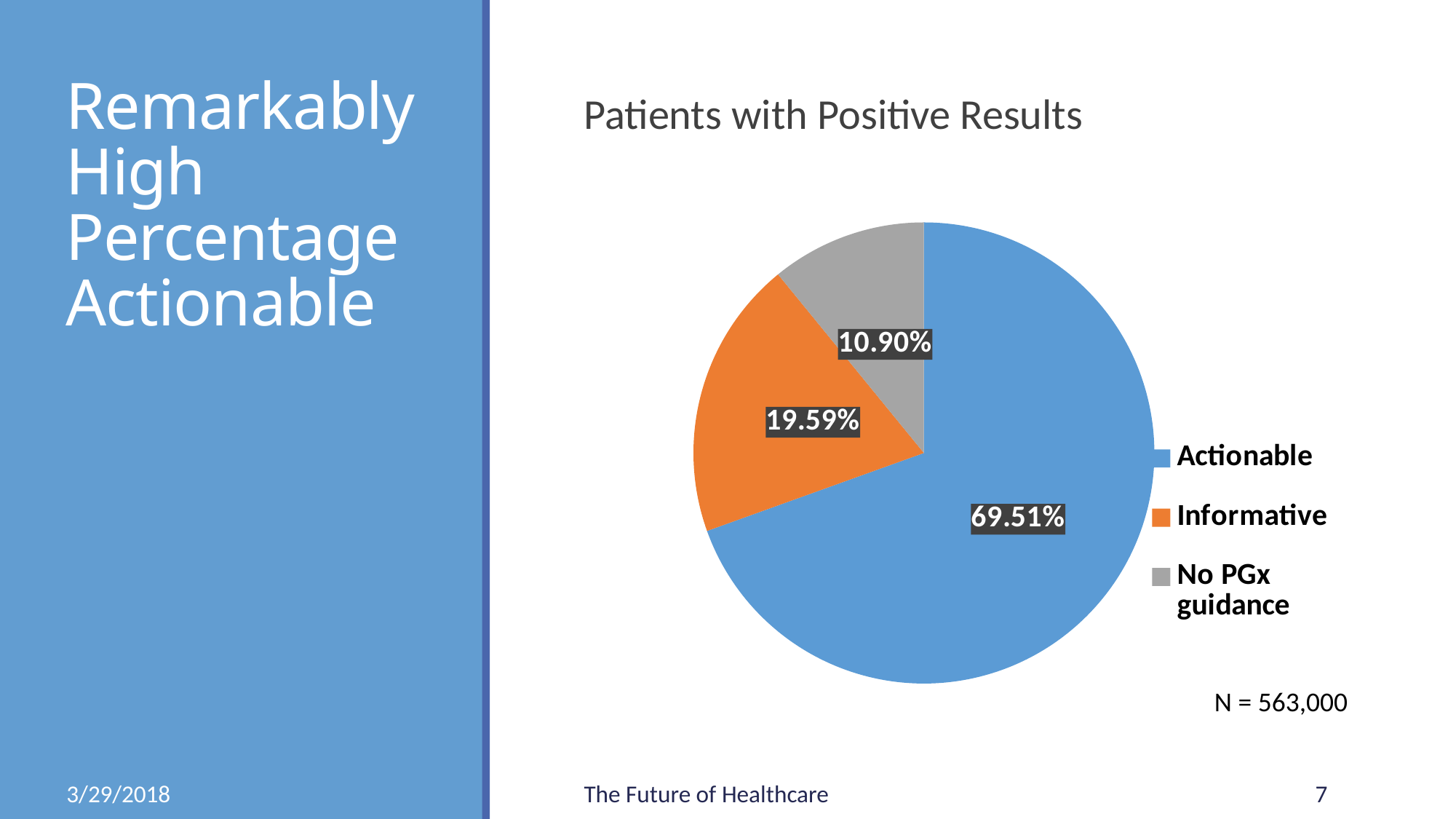
What type of chart is shown on the slide? pie chart What percentage of patients with positive results have No PGx guidance? 10.90% What is the difference in percentage points between the Actionable and Informative slices? 49.92 What is the title of the chart? Patients with Positive Results Which is larger, the Informative slice or the No PGx guidance slice? Informative Which category has the largest share of the pie? Actionable Which category has the smallest share of the pie? No PGx guidance How many categories does the pie chart show? 3 What percentage of patients with positive results are Informative? 19.59% What percentage of patients with positive results are Actionable? 69.51% What is the difference in percentage points between the Informative and No PGx guidance slices? 8.69 What colour is the Informative slice? orange